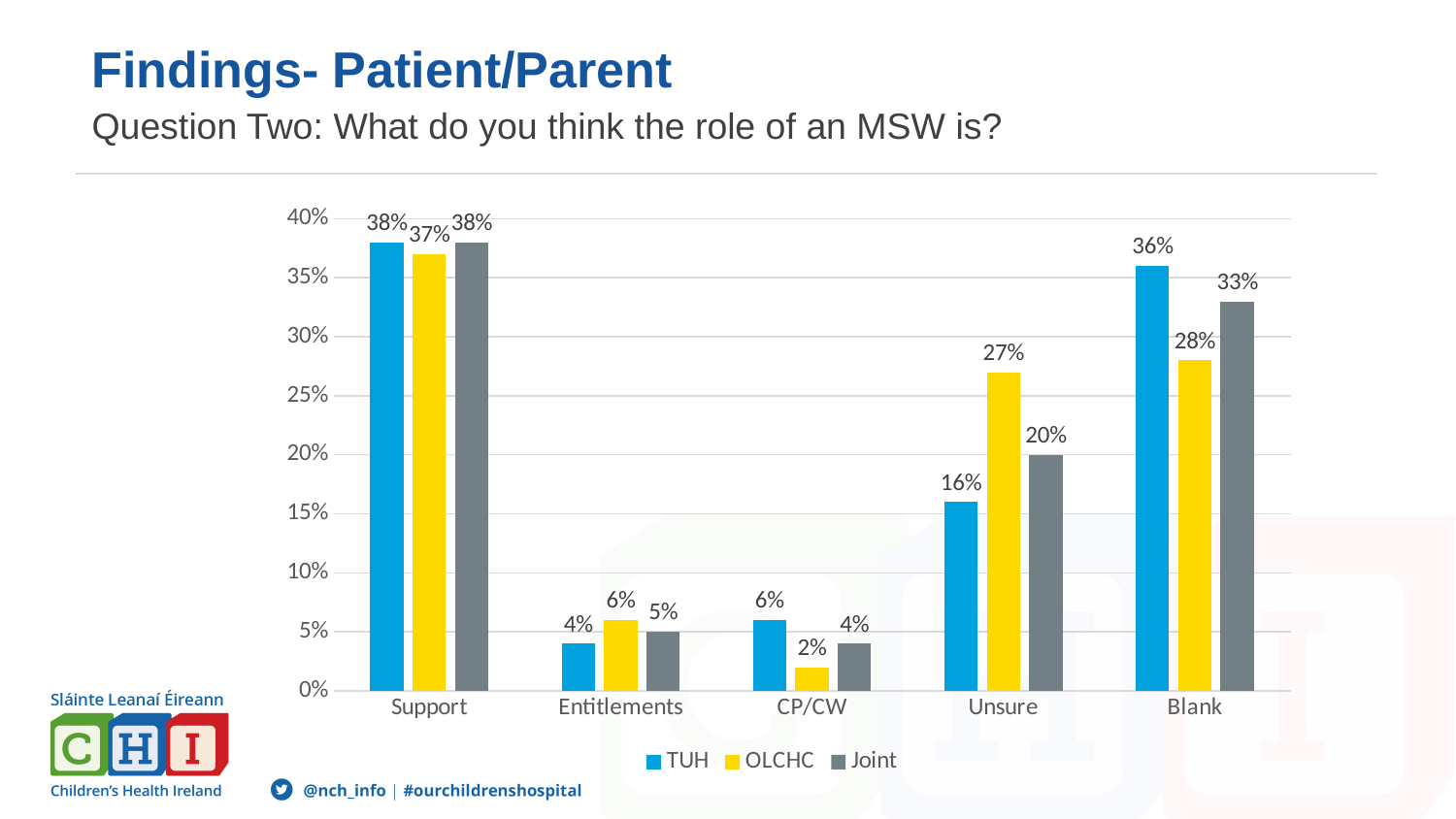
Which category has the highest OLCHC value? Support Which category has the lowest TUH value? Entitlements What is the OLCHC value for Unsure? 27% Which series is shown in yellow in the legend? OLCHC What is the TUH value for Support? 38% What is the Joint value for Blank? 33% What is the difference between the TUH and OLCHC values for Blank? 8% What kind of chart is shown on the slide? Bar chart What is the OLCHC value for CP/CW? 2% How many categories are shown on the x axis? 5 Which is larger for Unsure: the TUH value or the Joint value? Joint How many series does the legend list? 3